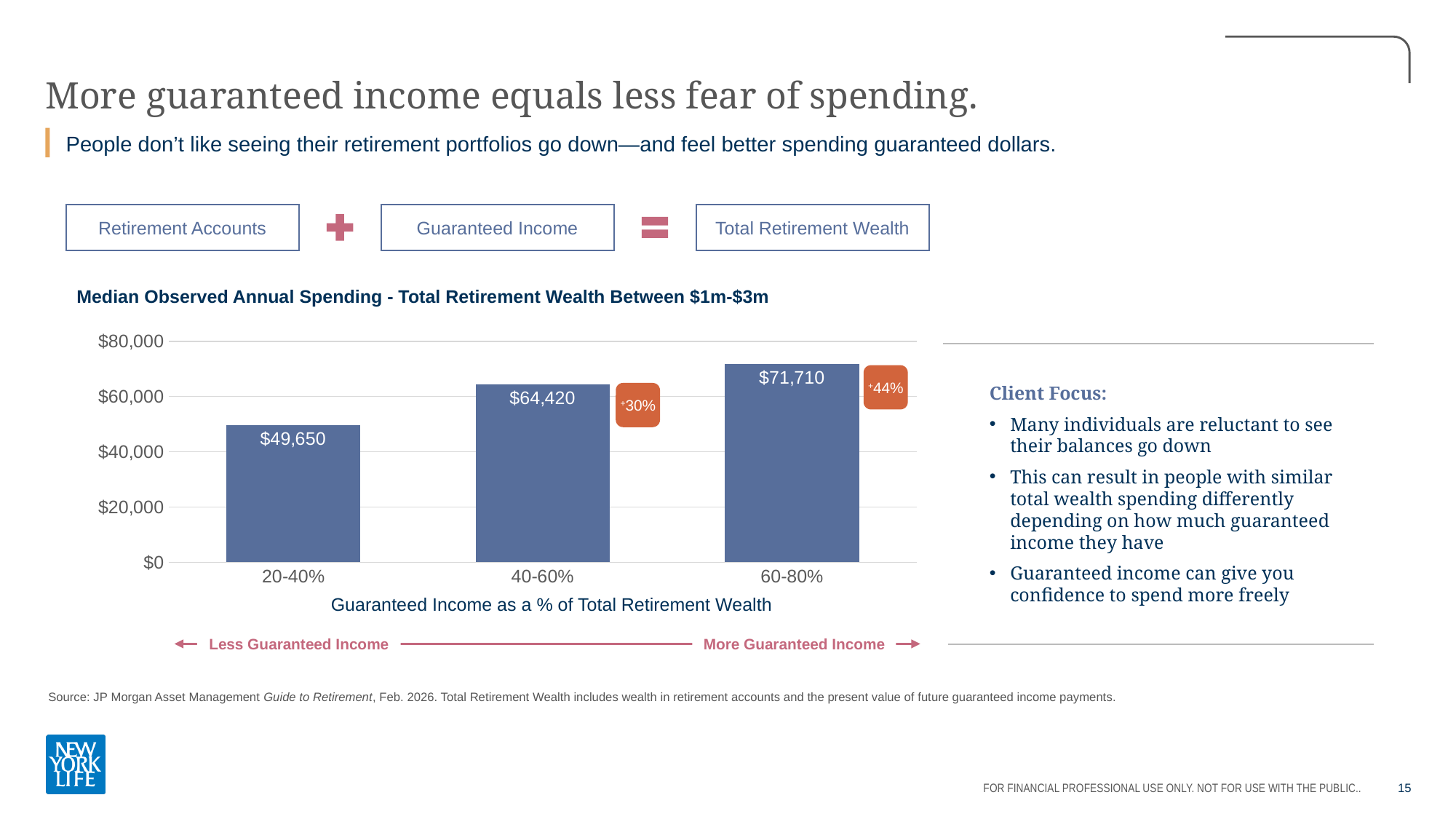
Is the median annual spending for the 20-40% group greater or less than $60,000? less What is the median observed annual spending for the 60-80% guaranteed income group? $71,710 Which guaranteed income group has the highest median observed annual spending? 60-80% Do the median annual spending values rise or fall as guaranteed income as a % of total retirement wealth increases? Rise What is the median observed annual spending for the 40-60% guaranteed income group? $64,420 Which group has higher median annual spending, 40-60% or 60-80%? 60-80% What is the difference in median annual spending between the 60-80% group and the 20-40% group? $22,060 What is the difference in median annual spending between the 40-60% group and the 20-40% group? $14,770 What is the median observed annual spending for the 20-40% guaranteed income group? $49,650 What kind of chart is used to show median observed annual spending? Bar chart How many guaranteed income categories are shown on the chart? 3 Which guaranteed income group has the lowest median observed annual spending? 20-40%